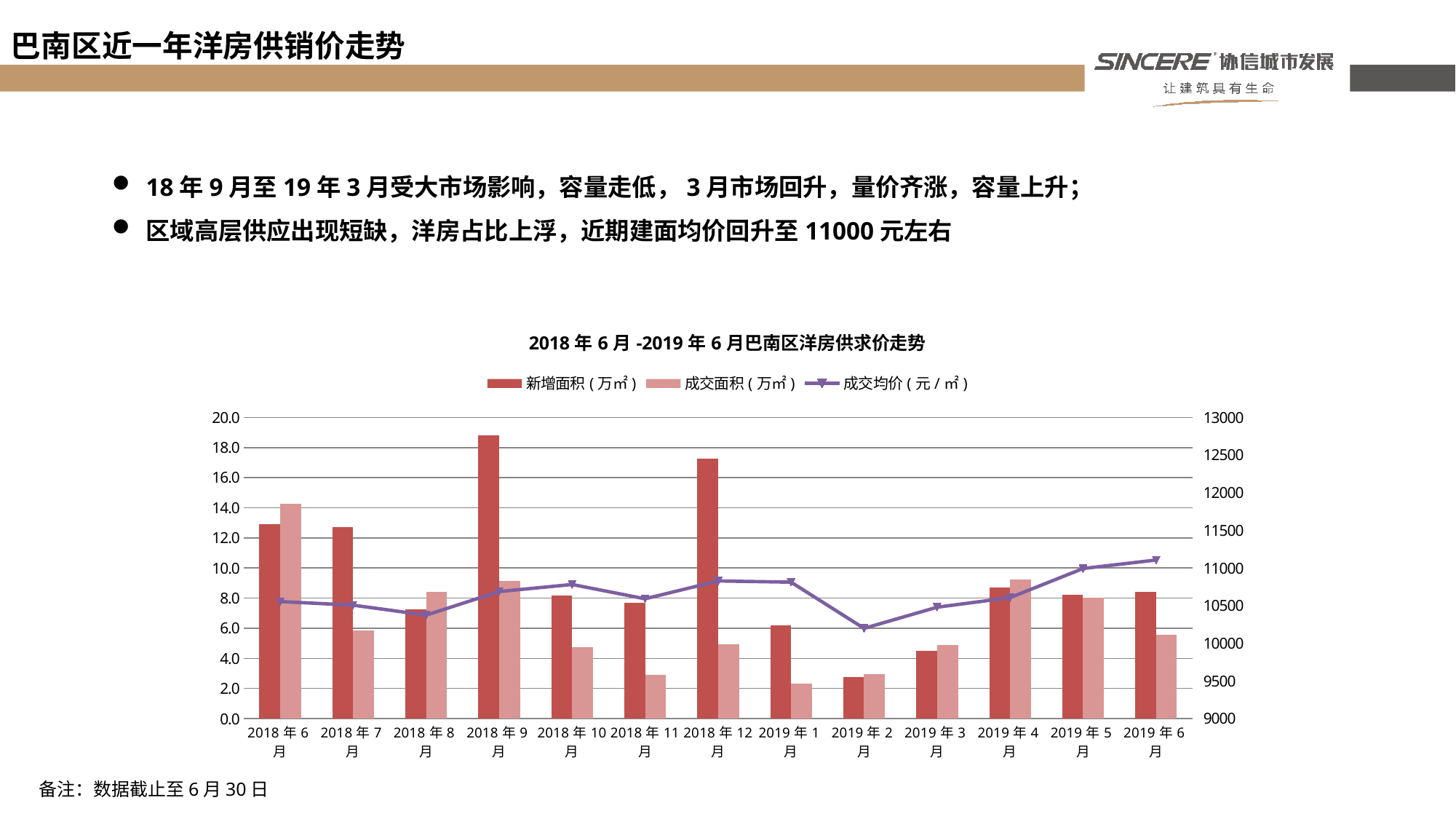
Which month has the highest 成交面积 (万㎡)? 2018年6月 What is the title of the chart? 2018年6月-2019年6月巴南区洋房供求价走势 Which month has the lowest 成交均价 (元/㎡)? 2019年2月 Is the 成交均价 for 2019年2月 greater or less than 10500? less Is the 新增面积 for 2018年9月 greater or less than 18.0? greater How many series does the chart legend list? 3 Which month has the highest 新增面积 (万㎡)? 2018年9月 How many months are shown on the x axis of the chart? 13 Which month has the lowest 新增面积 (万㎡)? 2019年2月 In 2018年6月, which is larger: 新增面积 or 成交面积? 成交面积 Does the 成交均价 line rise or fall from 2019年2月 to 2019年6月? rise What kind of chart is this? Combined bar and line chart